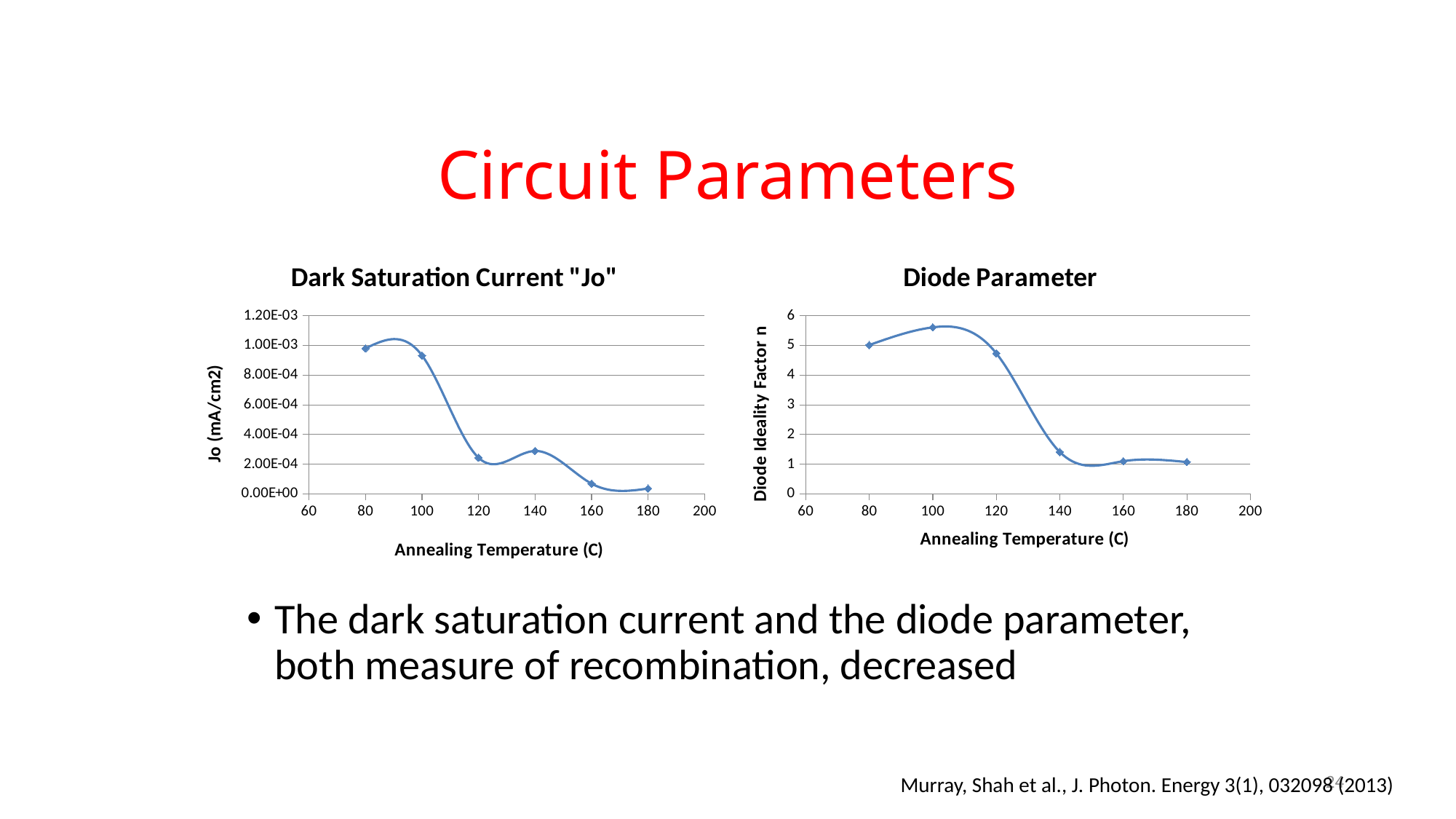
How many data points are plotted on the "Diode Parameter" chart? 6 On the "Dark Saturation Current "Jo"" chart, is the value at 80 C greater or less than 8.00E-04? greater On the "Dark Saturation Current "Jo"" chart, which has the larger Jo value: 100 C or 120 C? 100 C On the "Diode Parameter" chart, at which annealing temperature is the diode ideality factor highest? 100 On the "Diode Parameter" chart, is the diode ideality factor at 120 C greater or less than 4? greater What kind of chart is the "Dark Saturation Current "Jo"" chart? line chart On the "Dark Saturation Current "Jo"" chart, is the value at 160 C greater or less than 2.00E-04? less On the "Dark Saturation Current "Jo"" chart, at which annealing temperature is Jo lowest? 180 How many data points are plotted on the "Dark Saturation Current "Jo"" chart? 6 What is the y-axis title of the "Diode Parameter" chart? Diode Ideality Factor n On the "Diode Parameter" chart, does the diode ideality factor generally rise or fall as annealing temperature increases from 100 C to 180 C? fall